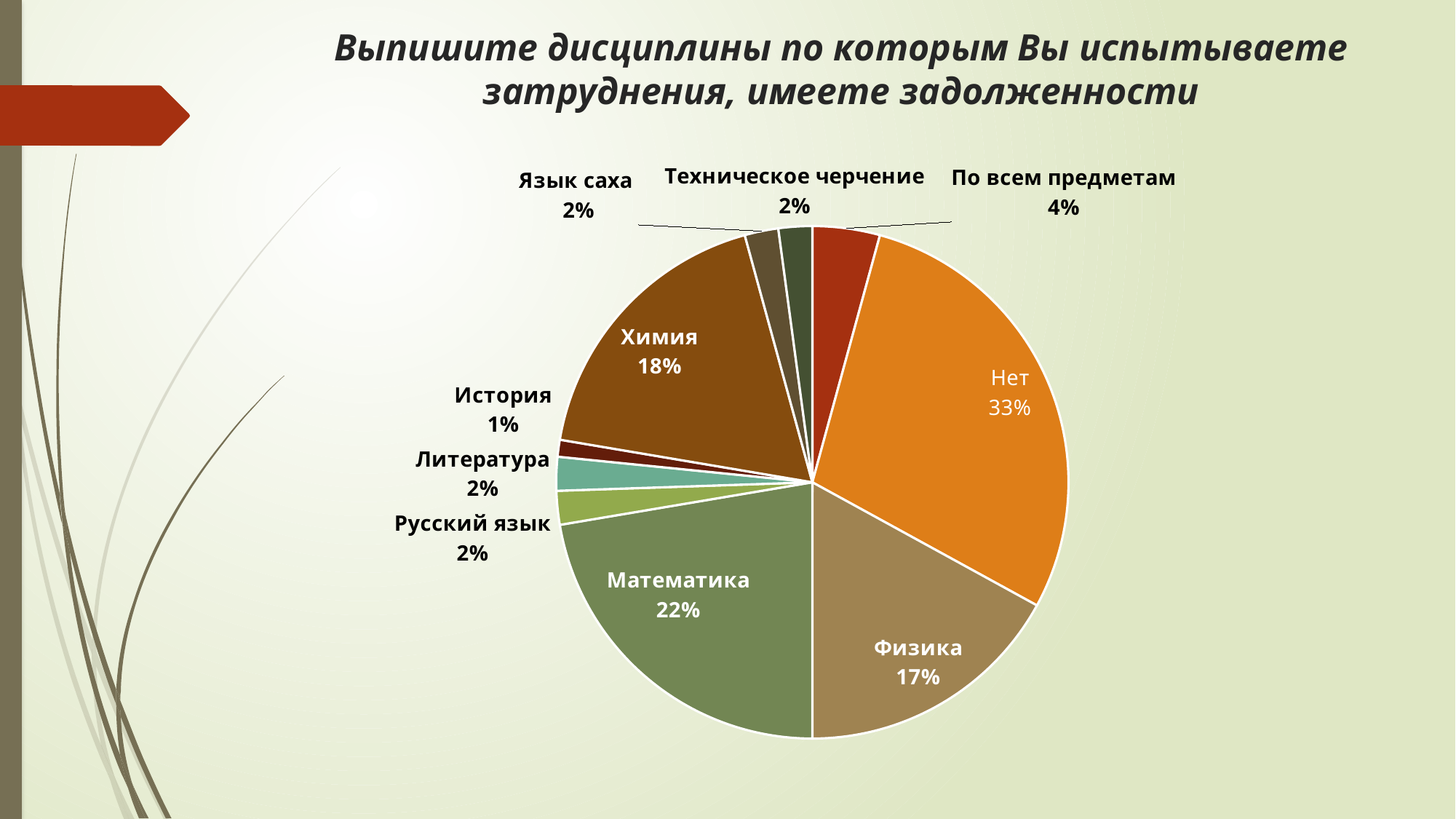
What is the difference between the values for Химия and История? 17% Which is larger, Химия or Физика? Химия What is the title of the slide? Выпишите дисциплины по которым Вы испытываете затруднения, имеете задолженности Which slice of the pie is the smallest? История What is the value for По всем предметам? 4% What kind of chart is shown on the slide? pie chart What share of the pie does Математика have? 22% Which slice of the pie is the largest? Нет What is the value shown for Физика? 17% How many slices does the pie chart have? 10 What percentage is shown for Химия? 18% What is the difference between the values for Нет and Математика? 11%